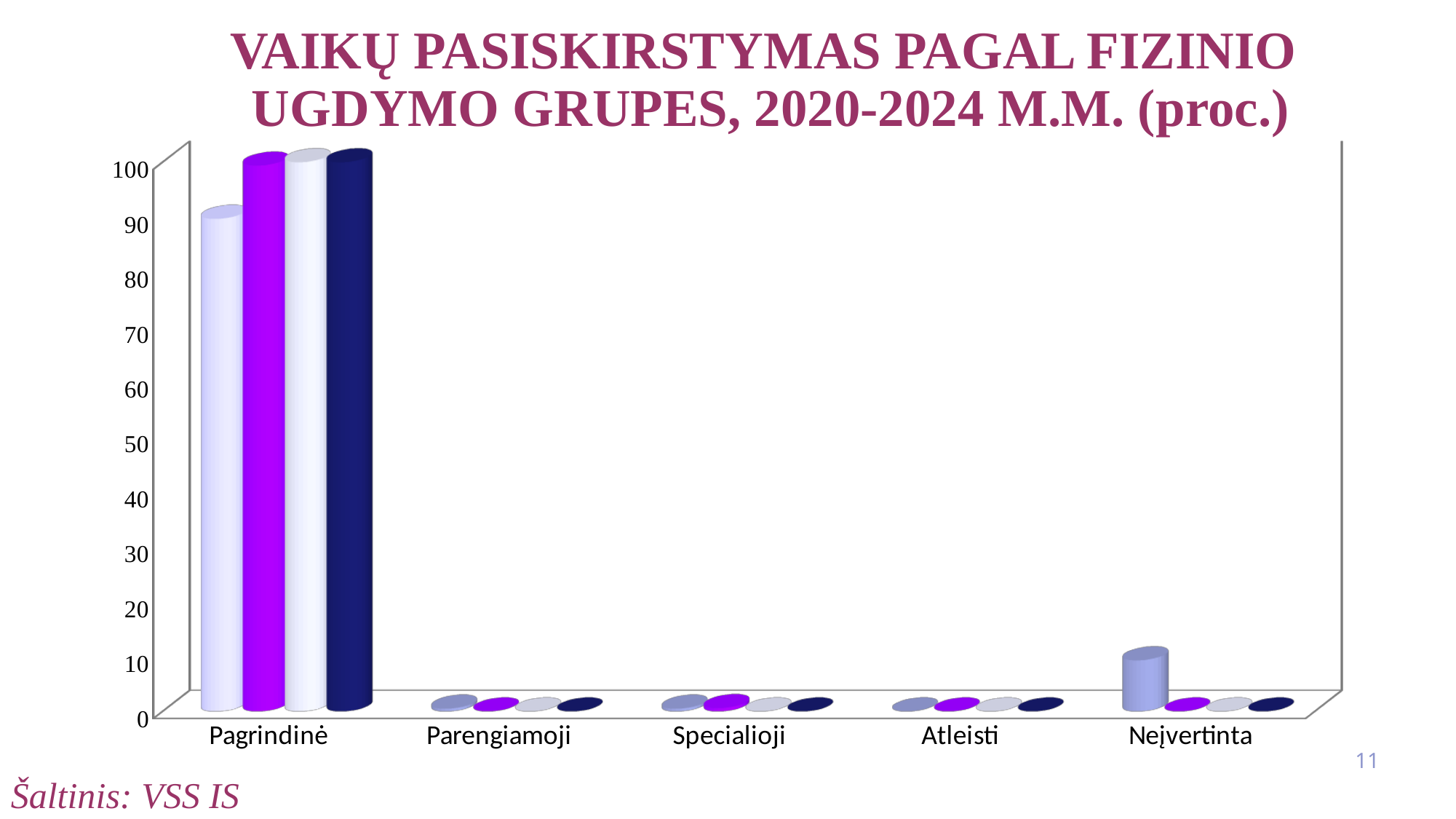
Are the values for Specialioji greater or less than 10? less Are the values for Pagrindinė greater or less than 80? greater Are the values for Atleisti greater or less than 10? less How many bars are plotted for each category in the chart? 4 What kind of chart is shown on the slide? bar chart Which category has the highest values in the chart? Pagrindinė What source is cited for the chart data on the slide? VSS IS Which category has larger values, Pagrindinė or Neįvertinta? Pagrindinė What is the title of the chart on the slide? VAIKŲ PASISKIRSTYMAS PAGAL FIZINIO UGDYMO GRUPES, 2020-2024 M.M. (proc.) How many categories are shown on the x axis of the chart? 5